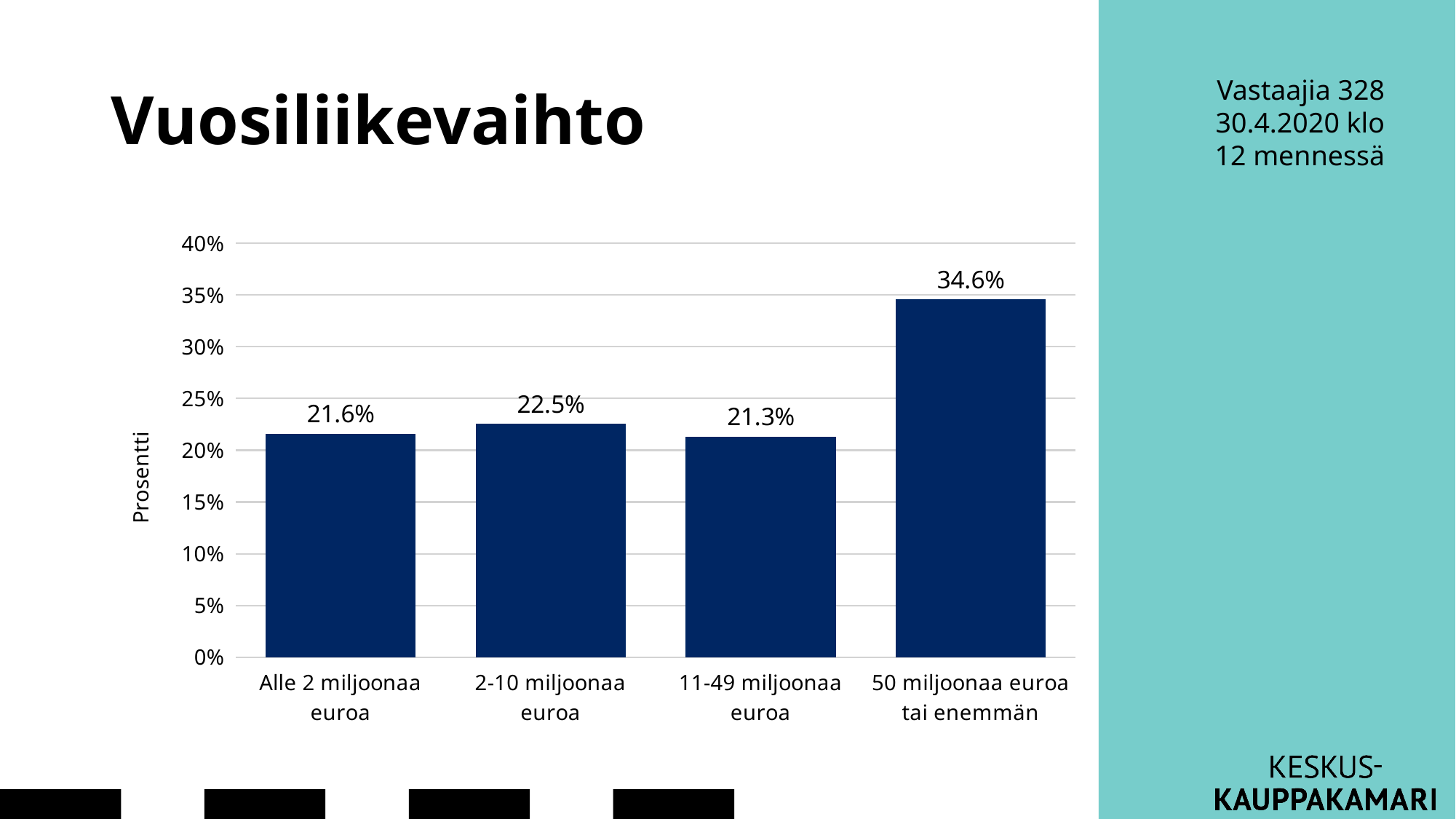
What is the value for "11-49 miljoonaa euroa"? 21.3% Is the value for "50 miljoonaa euroa tai enemmän" greater or less than 30%? greater What is the difference between the values for "2-10 miljoonaa euroa" and "11-49 miljoonaa euroa"? 1.2% What is the value for "Alle 2 miljoonaa euroa"? 21.6% What kind of chart is shown on the slide? bar chart What is the value for "2-10 miljoonaa euroa"? 22.5% What is the value for "50 miljoonaa euroa tai enemmän"? 34.6% How many categories are shown on the x axis? 4 What is the title of the chart on the slide? Vuosiliikevaihto What is the difference between the values for "50 miljoonaa euroa tai enemmän" and "2-10 miljoonaa euroa"? 12.1% Which category has the highest value? 50 miljoonaa euroa tai enemmän Which is larger, the value for "50 miljoonaa euroa tai enemmän" or the value for "Alle 2 miljoonaa euroa"? 50 miljoonaa euroa tai enemmän